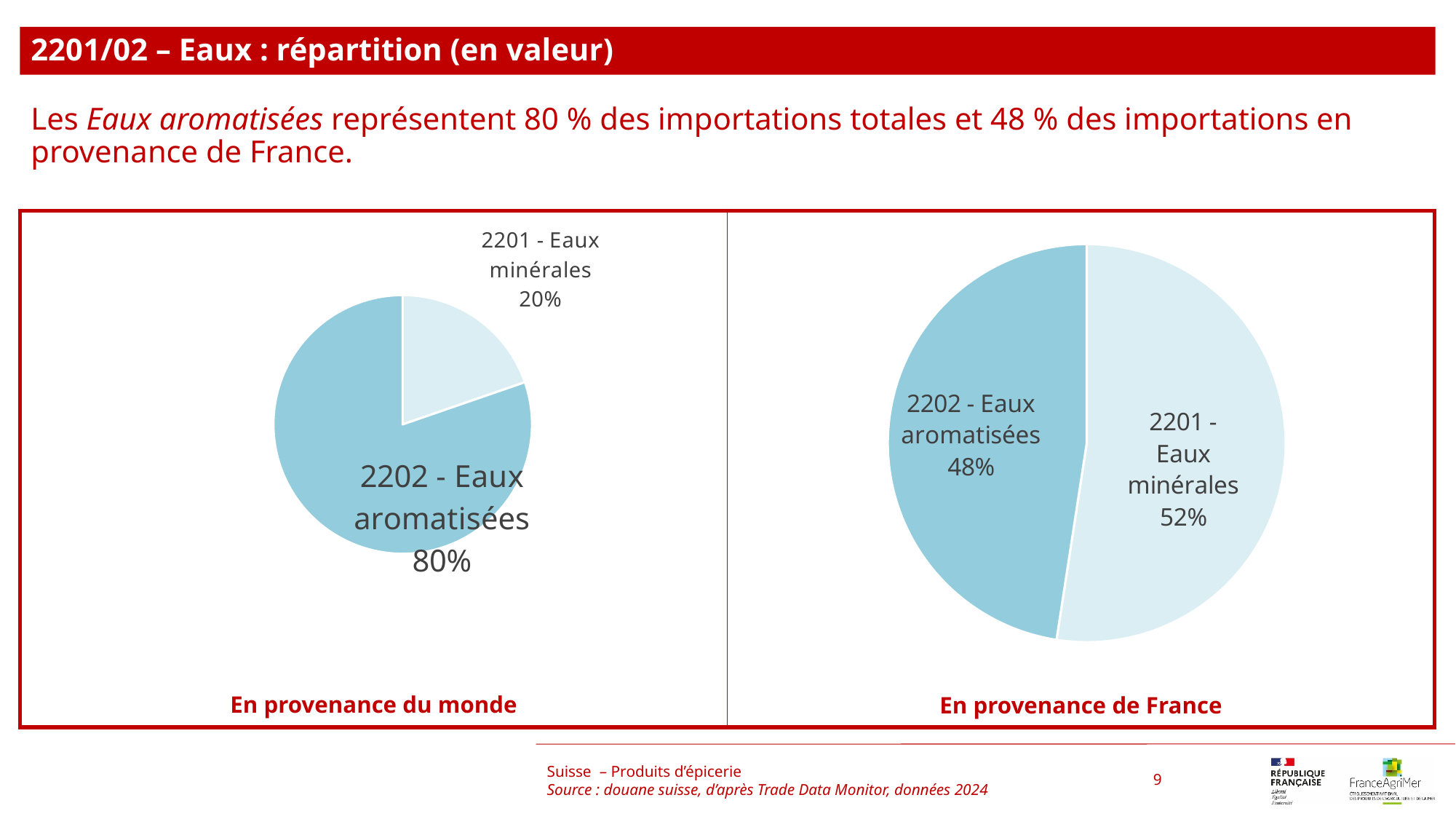
In the 'En provenance du monde' pie chart, what is the difference in percentage points between the two slices? 60 How many slices does the 'En provenance de France' pie chart have? 2 In the 'En provenance de France' pie chart, what share does '2201 - Eaux minérales' have? 52% In the 'En provenance de France' pie chart, what is the difference in percentage points between '2201 - Eaux minérales' and '2202 - Eaux aromatisées'? 4 How many pie charts are shown on the slide? 2 In the 'En provenance de France' pie chart, what share does '2202 - Eaux aromatisées' have? 48% What kind of chart is used in the 'En provenance du monde' panel? Pie chart In the 'En provenance du monde' pie chart, what share does '2201 - Eaux minérales' have? 20% Is the share of '2202 - Eaux aromatisées' larger in the 'En provenance du monde' chart or in the 'En provenance de France' chart? En provenance du monde In the 'En provenance du monde' pie chart, which category has the largest share? 2202 - Eaux aromatisées In the 'En provenance de France' pie chart, which category has the smallest share? 2202 - Eaux aromatisées